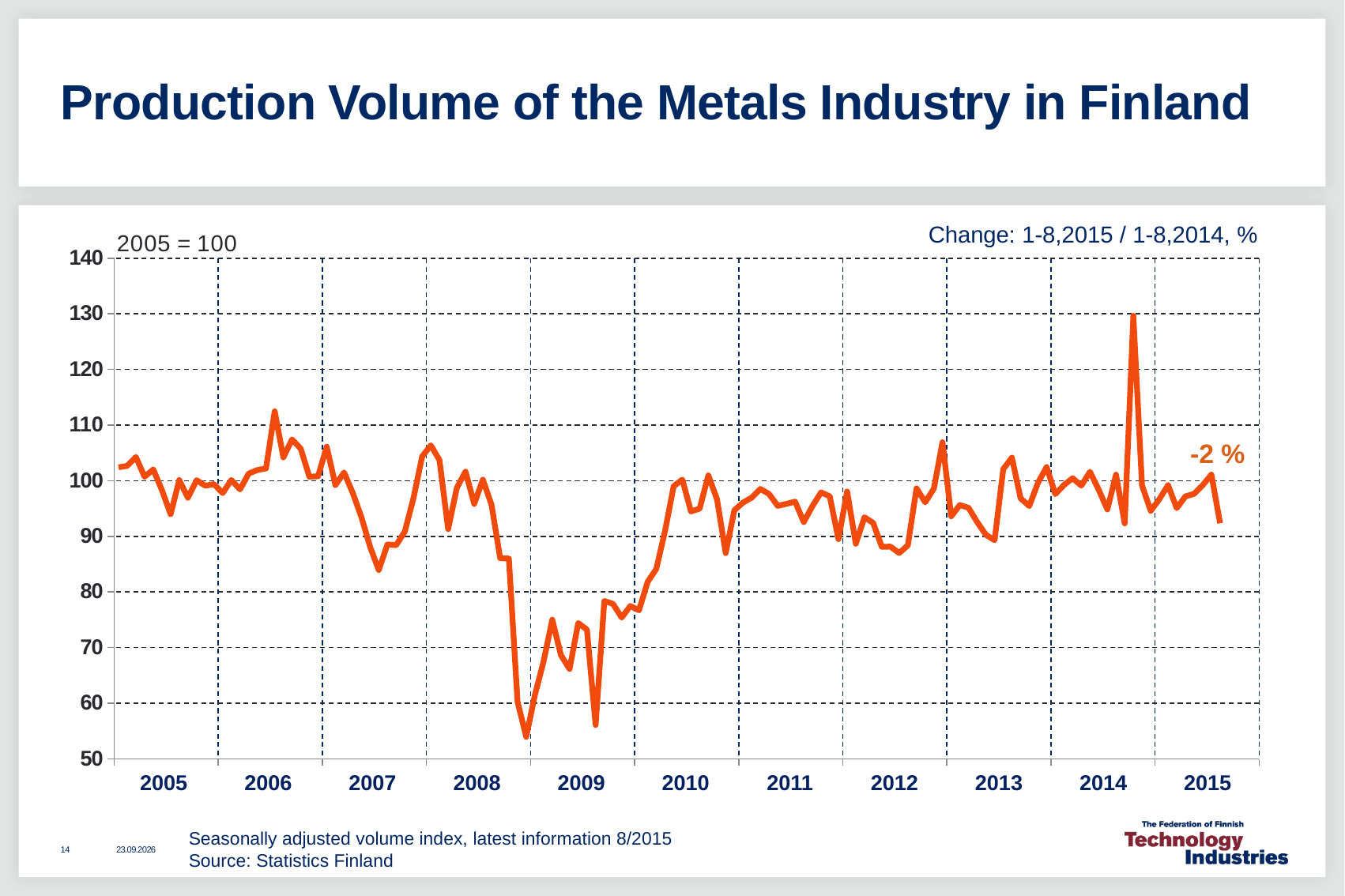
Does the line rise or fall between the start of 2009 and the start of 2010? rise Is the lowest value in late 2008 greater or less than 60? less What is the title of the chart? Production Volume of the Metals Industry in Finland In which year does the line reach its highest peak? 2014 What is the change for 1-8,2015 / 1-8,2014 shown on the chart? -2 % In which year does the line reach its lowest point? 2008 How many year labels are shown on the x axis? 11 What kind of chart is shown on the slide? line chart Is the peak value in 2014 greater or less than 120? greater Does the line rise or fall between early 2008 and the end of 2008? fall What is the highest value shown on the y axis? 140 What base year and value does the index use, as noted above the chart? 2005 = 100